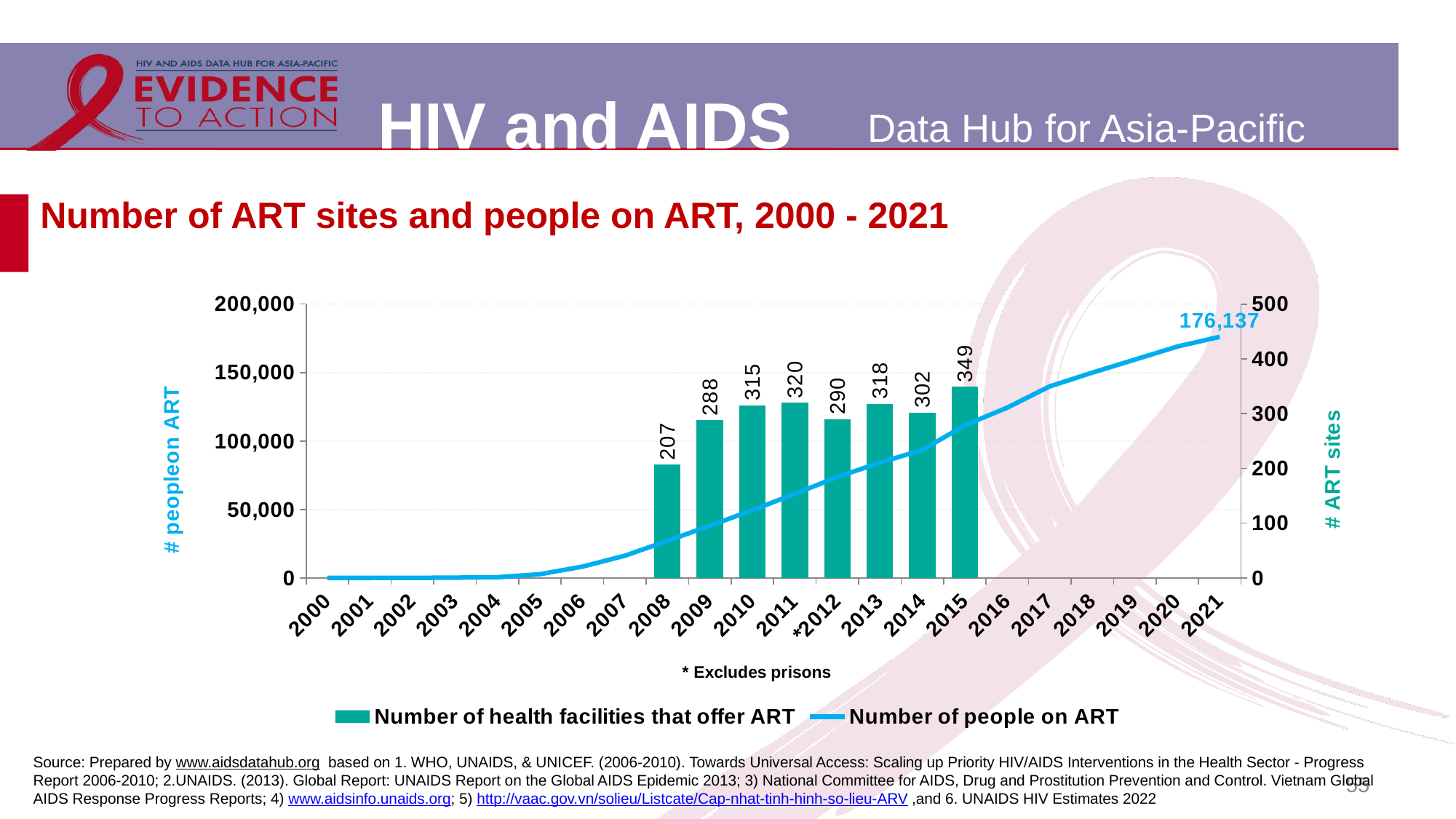
What is the number of health facilities that offer ART in 2015? 349 How many series does the legend list? 2 Which year has more health facilities that offer ART, 2013 or 2014? 2013 In which year is the number of health facilities that offer ART lowest? 2008 How many years have a bar for the number of health facilities that offer ART? 8 What is the number of people on ART in 2021? 176,137 In which year is the number of health facilities that offer ART highest? 2015 Does the number of people on ART rise or fall from 2000 to 2021? Rise Is the number of people on ART in 2018 greater or less than 100,000? greater What is the number of health facilities that offer ART in 2008? 207 What is the difference between the number of health facilities that offer ART in 2015 and in 2008? 142 What kind of chart is shown on the slide? Combined bar and line chart